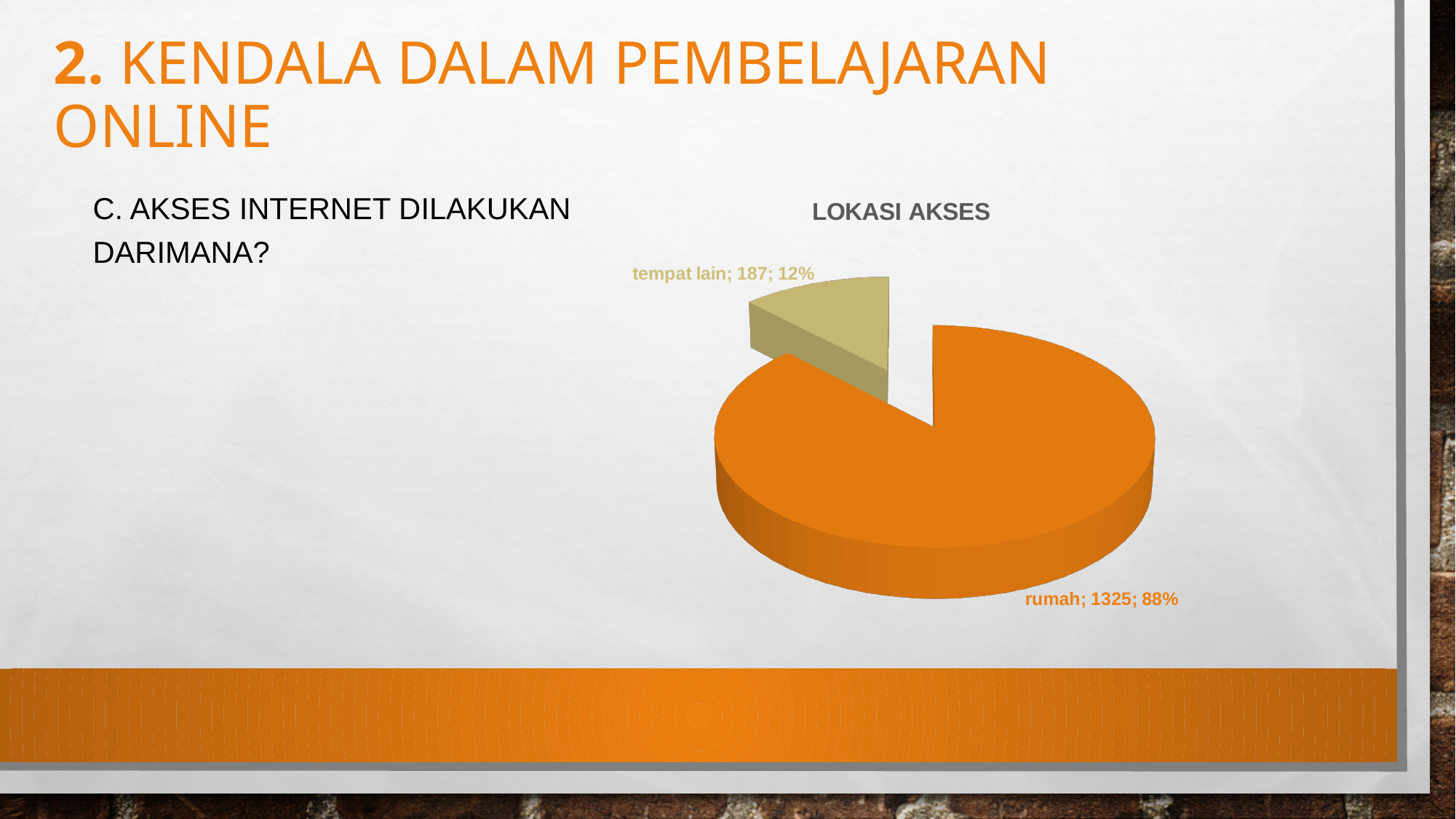
What share of the pie does rumah represent? 88% How many slices does the pie chart have? 2 What is the difference between the values for rumah and tempat lain? 1138 What kind of chart is shown on the slide? pie chart Which category has the largest slice? rumah What is the total of the two slices in the pie chart? 1512 What is the value for rumah? 1325 Which category has the smallest slice? tempat lain What is the title of the chart? LOKASI AKSES What share of the pie does tempat lain represent? 12% Which is larger, the value for rumah or the value for tempat lain? rumah What is the value for tempat lain? 187